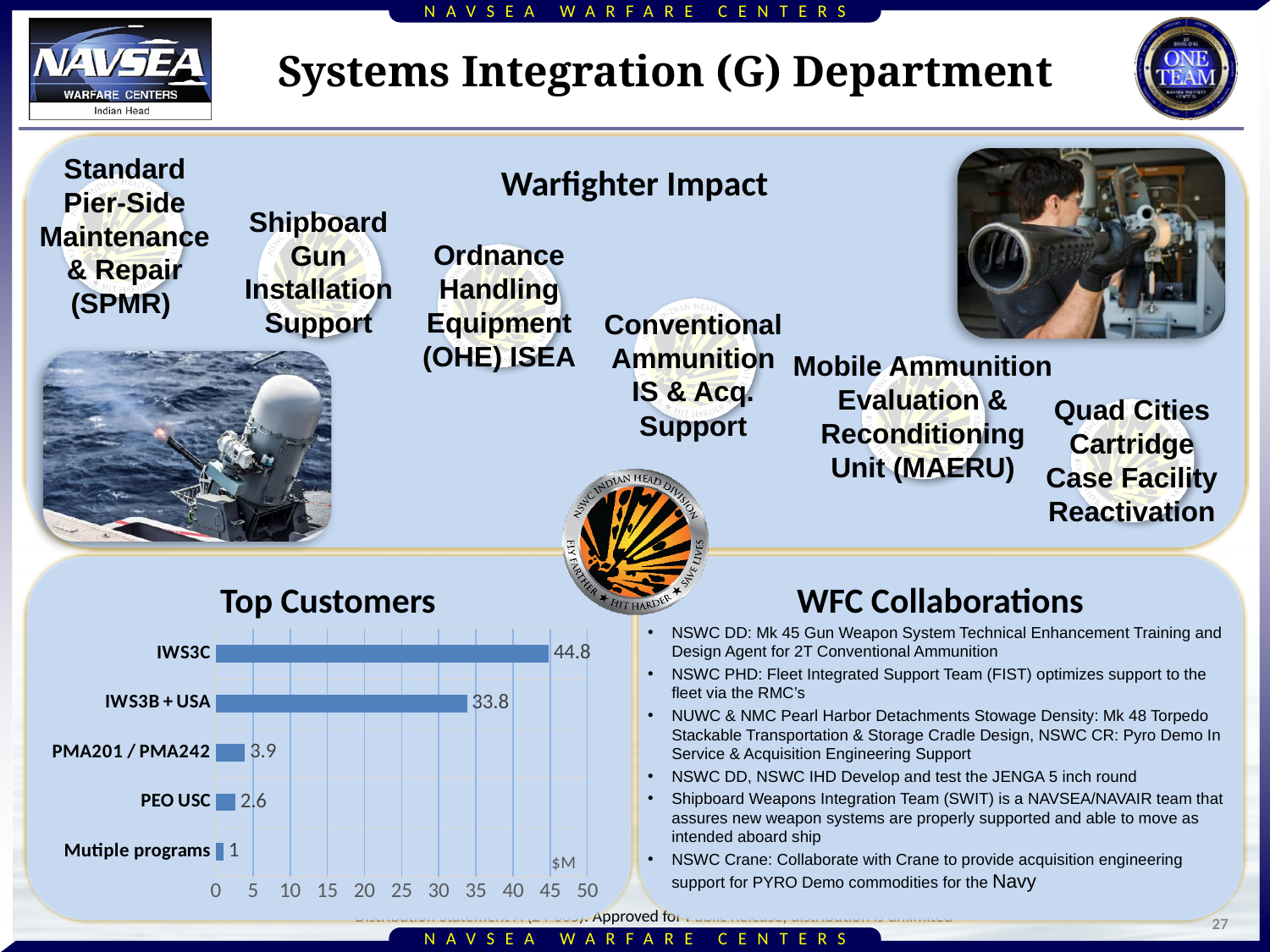
How many categories are shown in the Top Customers chart? 5 What kind of chart is the Top Customers chart? bar chart What is the value for PEO USC in the Top Customers chart? 2.6 Is the value for IWS3B + USA in the Top Customers chart greater or less than 30? greater What is the value for PMA201 / PMA242 in the Top Customers chart? 3.9 What unit label is shown on the x axis of the Top Customers chart? $M Which customer has the highest value in the Top Customers chart? IWS3C What is the value for IWS3B + USA in the Top Customers chart? 33.8 What is the value for IWS3C in the Top Customers chart? 44.8 In the Top Customers chart, which is larger: PMA201 / PMA242 or PEO USC? PMA201 / PMA242 What is the difference between the values for IWS3C and IWS3B + USA in the Top Customers chart? 11 Which category has the lowest value in the Top Customers chart? Mutiple programs